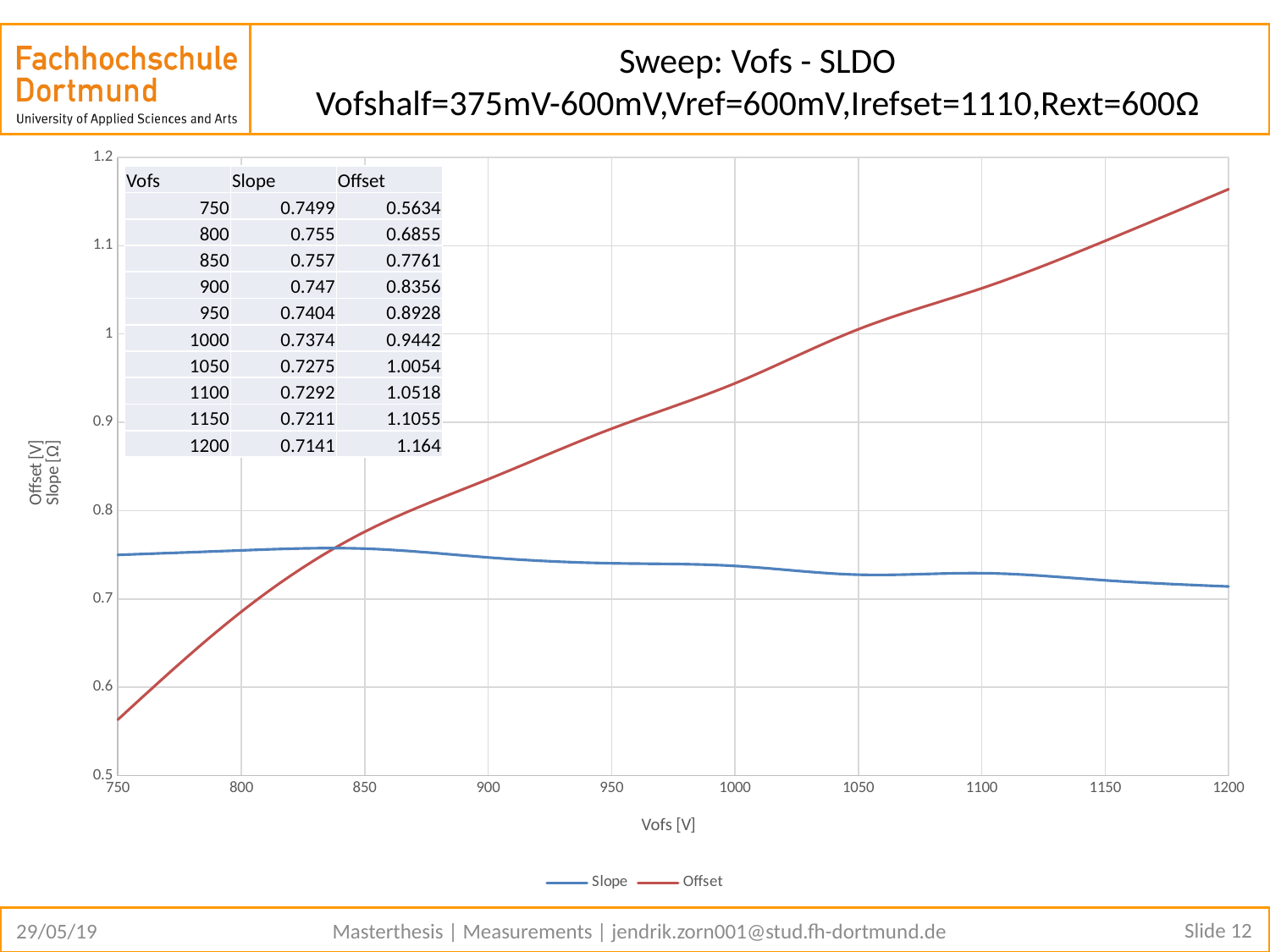
At which Vofs value is the Offset lowest? 750 What is the Offset value at Vofs = 1200? 1.164 What is the Offset value at Vofs = 1000? 0.9442 What kind of chart is shown on the slide? line chart At which Vofs value is the Slope highest? 850 What is the difference between the Offset at Vofs = 1200 and the Offset at Vofs = 750? 0.6006 What is the Slope value at Vofs = 850? 0.757 Does the Offset series rise or fall as Vofs increases from 750 to 1200? rise What colour is the Offset line in the chart? red How many series does the legend list? 2 How many Vofs data points are listed in the table on the chart? 10 Which is larger at Vofs = 1100: the Slope or the Offset? Offset